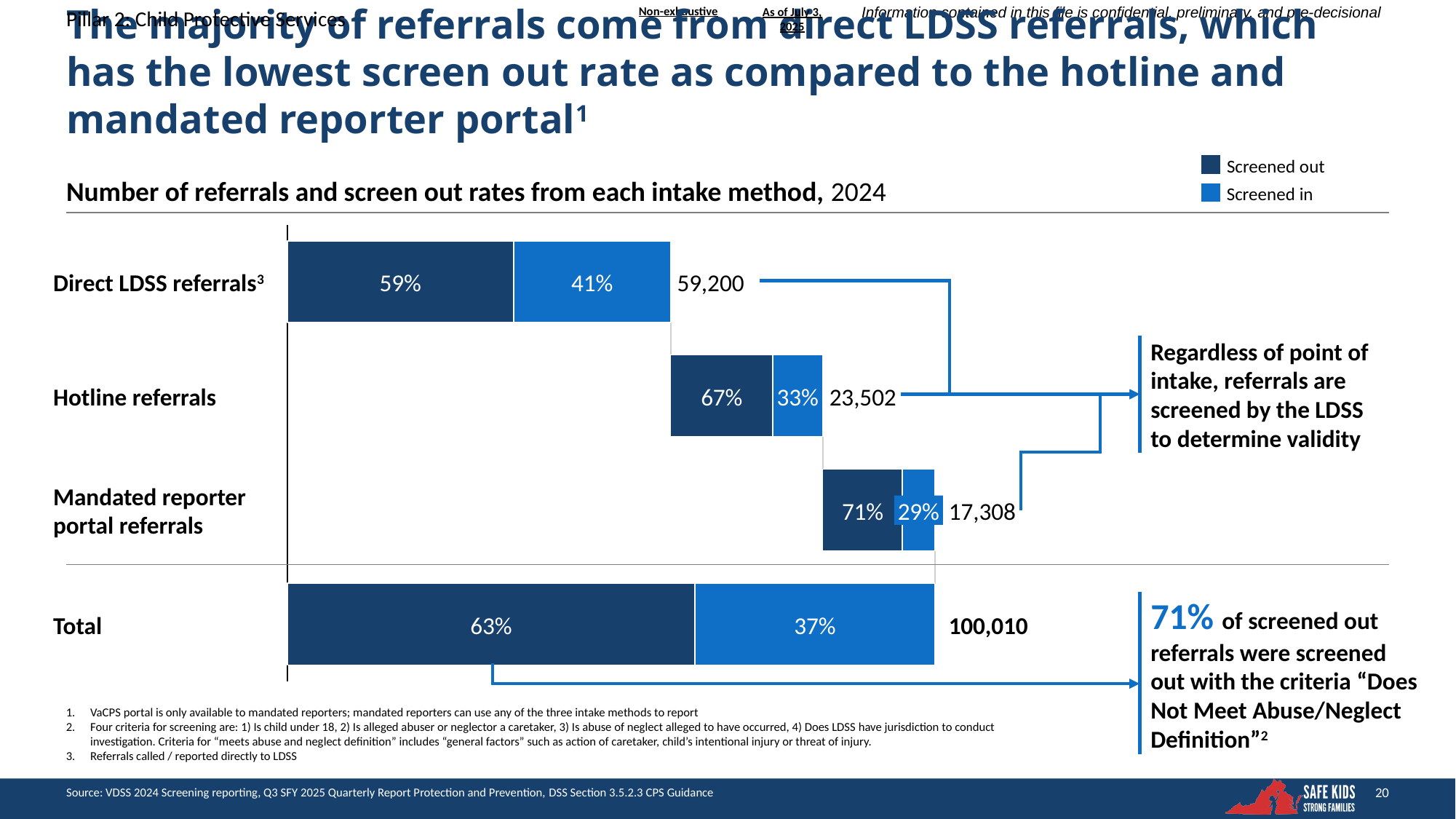
What is the difference in number of referrals between Direct LDSS referrals and Hotline referrals? 35,698 What is the total number of referrals shown for 2024? 100,010 Which has a higher screened out rate, Hotline referrals or Direct LDSS referrals? Hotline referrals How many series does the legend list? 2 Which legend entry is shown in the darker blue colour? Screened out How many referrals came through the Mandated reporter portal? 17,308 Which intake method has the highest screened out rate? Mandated reporter portal referrals What is the screened out rate for Direct LDSS referrals? 59% What is the screened in rate for Hotline referrals? 33% What kind of chart is shown on the slide? Stacked bar chart How many intake methods are shown in the chart, excluding the Total row? 3 Which intake method has the lowest number of referrals? Mandated reporter portal referrals